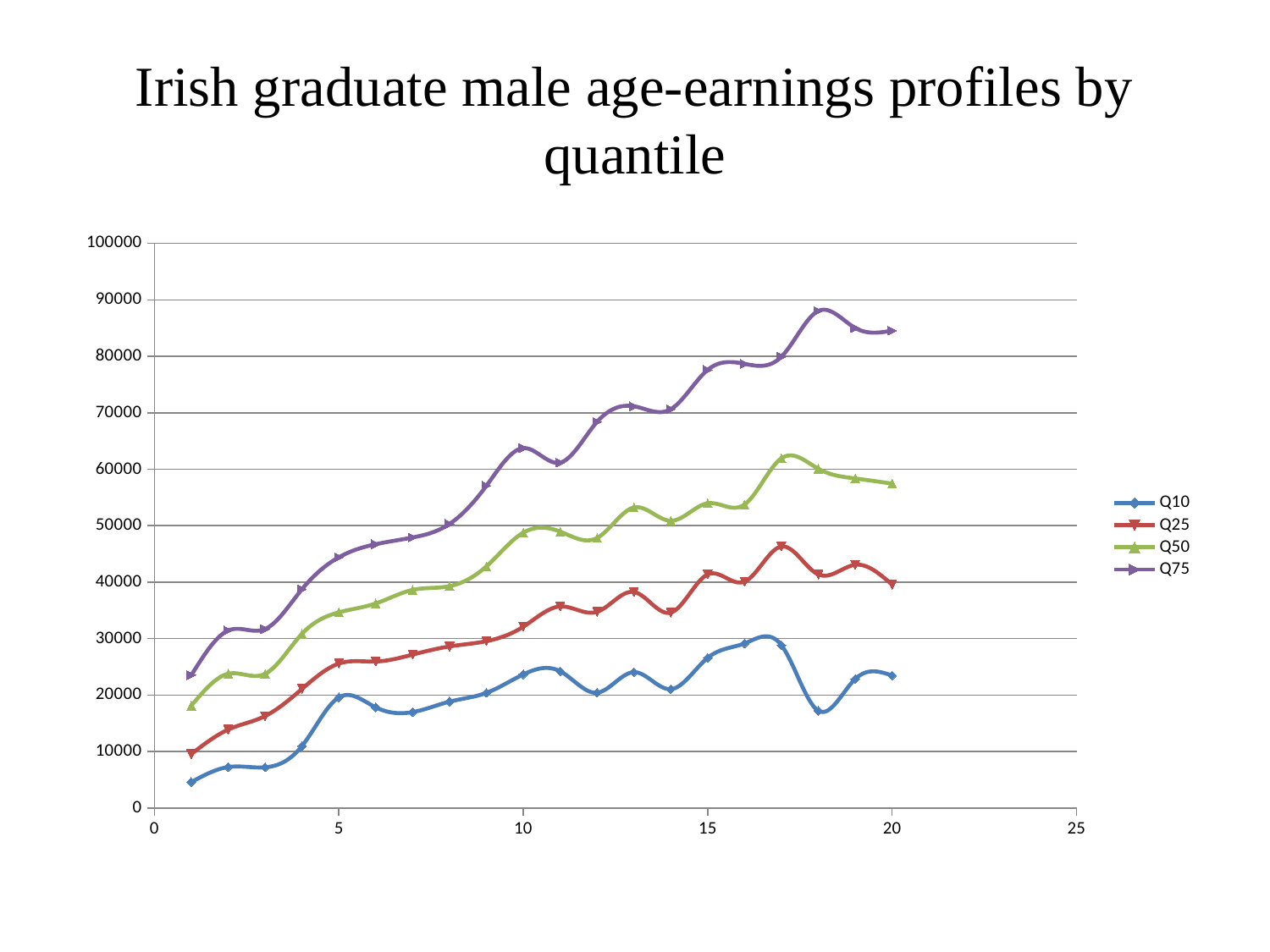
What kind of chart is shown on the slide? line chart Do the Q75 values generally rise or fall as x increases from 1 to 18? rise Is the value for Q10 at x = 1 greater or less than 10000? less Is the value for Q50 at x = 20 greater or less than 50000? greater At x = 10, which series has the larger value, Q75 or Q10? Q75 Which series is plotted lowest across the chart? Q10 Which series is plotted highest across the chart? Q75 Is the value for Q75 at x = 18 greater or less than 80000? greater What is the title of the chart? Irish graduate male age-earnings profiles by quantile How many data points does the Q75 series have? 20 How many series does the legend list? 4